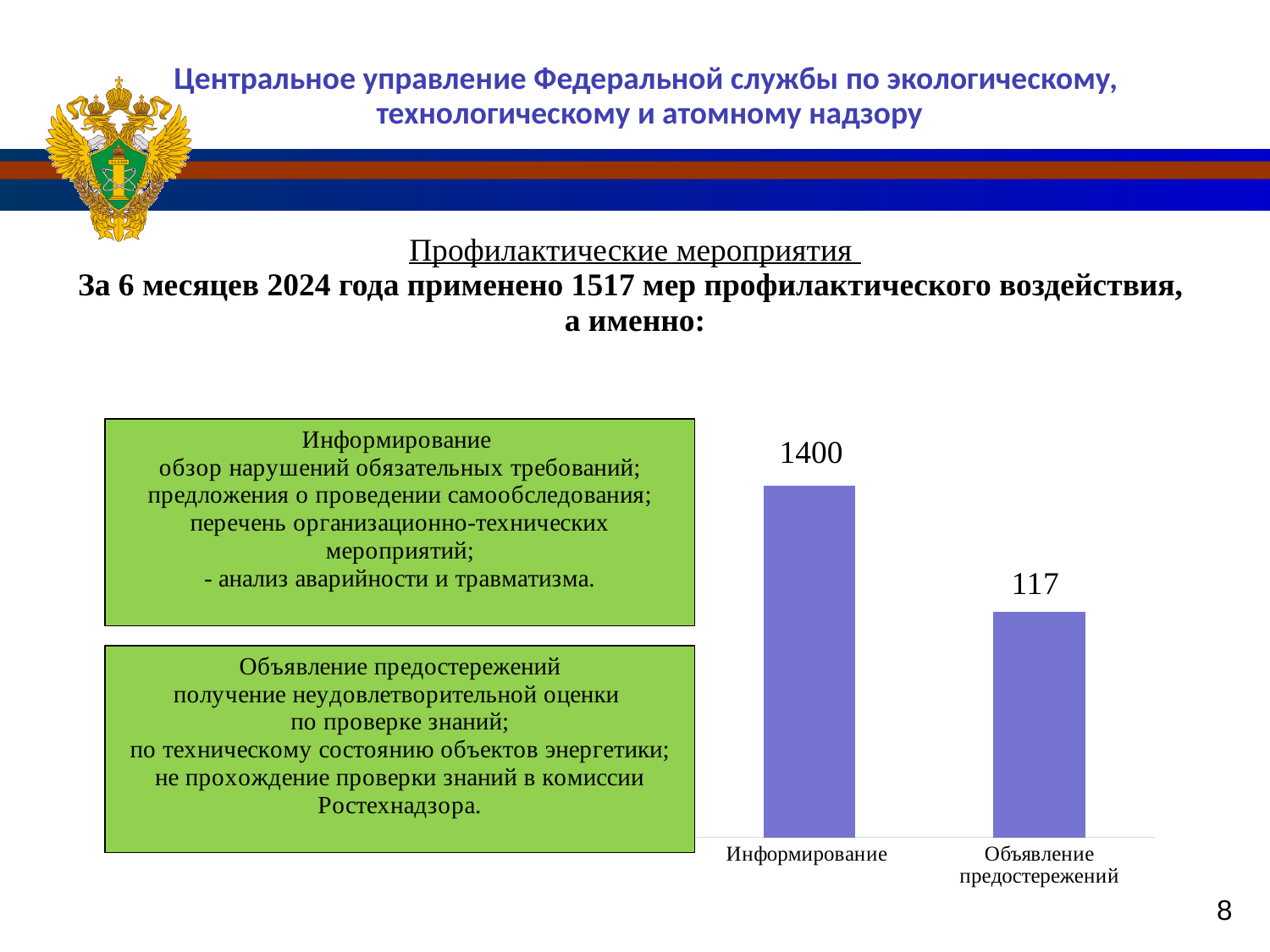
What kind of chart is shown on the slide? bar chart Which is larger, the value for Информирование or the value for Объявление предостережений? Информирование What is the difference between the values for Информирование and Объявление предостережений? 1283 What colour are the bars in the chart? purple How many categories are shown in the chart? 2 Which category has the lowest value? Объявление предостережений What is the total of the two values shown in the chart? 1517 What is the value for Объявление предостережений? 117 Which category has the highest value? Информирование Do the values rise or fall from left to right along the x axis? fall What is the value for Информирование? 1400